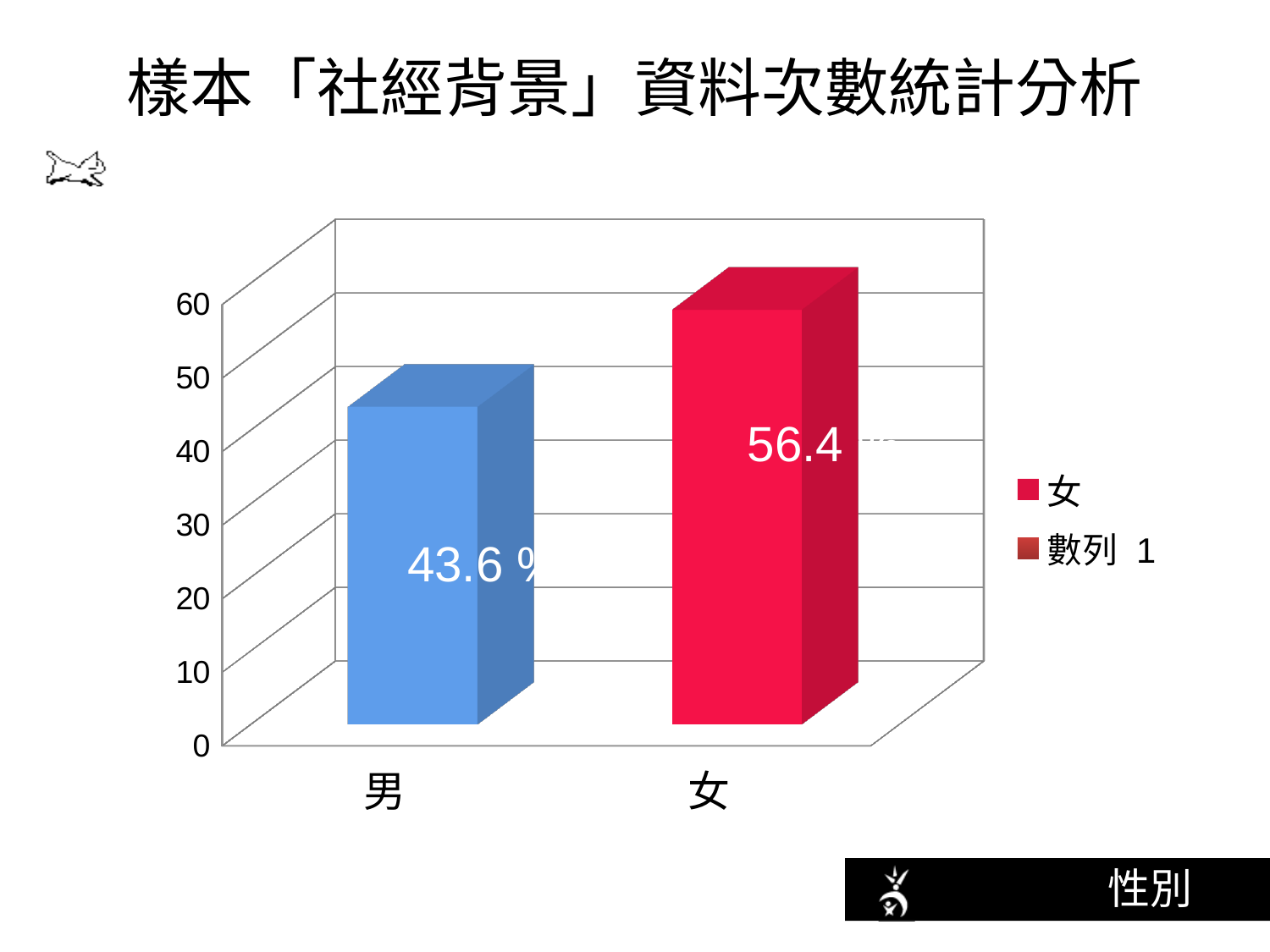
How many categories are shown on the x axis? 2 Is the value for 男 greater or less than 40? greater What value is labelled on the bar for 女? 56.4 What value is labelled on the bar for 男? 43.6 % What is the title of the slide? 樣本「社經背景」資料次數統計分析 Is the value for 女 greater or less than 60? less Which category has the lowest bar? 男 How many entries does the legend list? 2 What kind of chart is shown on the slide? bar chart What is the difference between the labelled values for 女 and 男? 12.8 Which category has the highest bar? 女 Which is larger, the value for 男 or the value for 女? 女